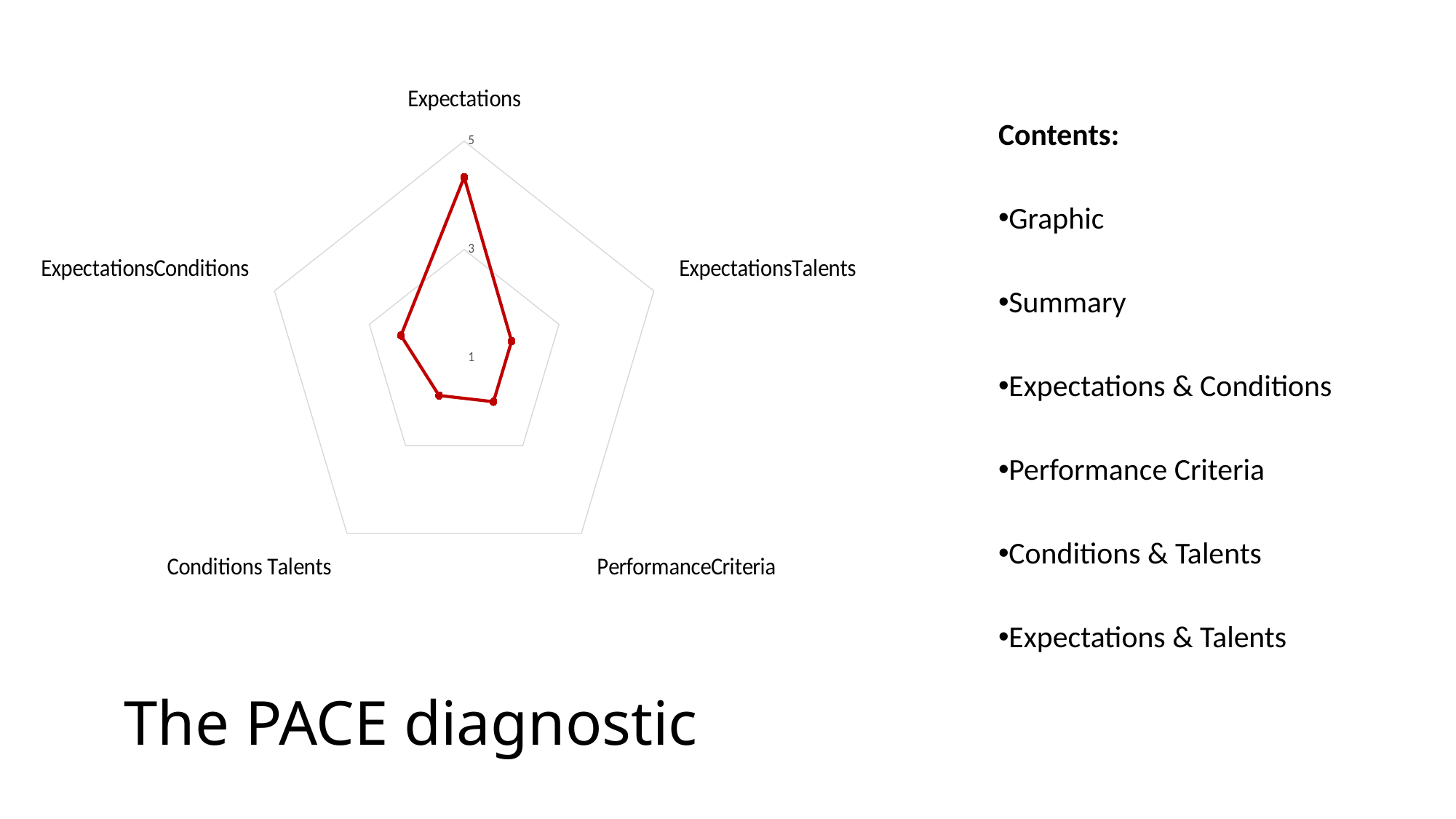
Is the value for ExpectationsConditions greater or less than 3? less Is the value for PerformanceCriteria greater or less than 3? less How many categories (axes) does the radar chart have? 5 Is the value for Conditions Talents greater or less than 3? less Which is larger, the value for Expectations or the value for ExpectationsConditions? Expectations What is the highest tick value shown on the radar chart's axis? 5 What kind of chart is shown on the slide? Radar chart What colour is the data line plotted on the radar chart? Red Which category has the highest value on the radar chart? Expectations